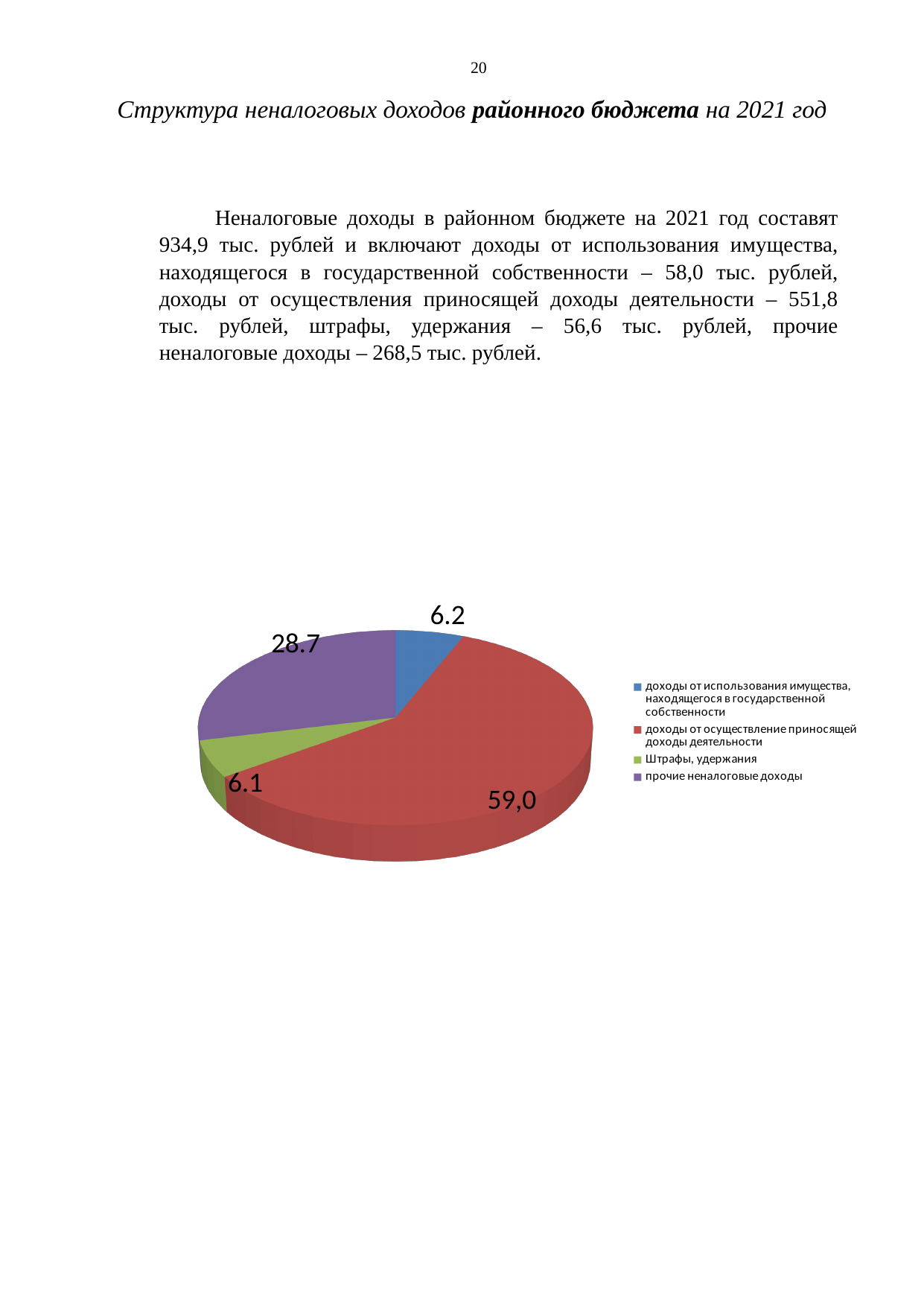
What is the difference between the value for 'доходы от осуществление приносящей доходы деятельности' and the value for 'прочие неналоговые доходы'? 30.3 What value is shown for the slice 'доходы от использования имущества, находящегося в государственной собственности'? 6.2 How many entries does the legend of the pie chart list? 4 What value is shown for the slice 'Штрафы, удержания'? 6.1 Which is larger: the slice for 'прочие неналоговые доходы' or the slice for 'доходы от использования имущества, находящегося в государственной собственности'? прочие неналоговые доходы What value is shown for the slice 'доходы от осуществление приносящей доходы деятельности'? 59,0 What kind of chart is shown on the slide? pie chart Which category has the smallest slice of the pie chart? Штрафы, удержания What colour is the largest slice of the pie chart? red Which category has the largest slice of the pie chart? доходы от осуществление приносящей доходы деятельности What value is shown for the slice 'прочие неналоговые доходы'? 28.7 How many slices does the pie chart have? 4